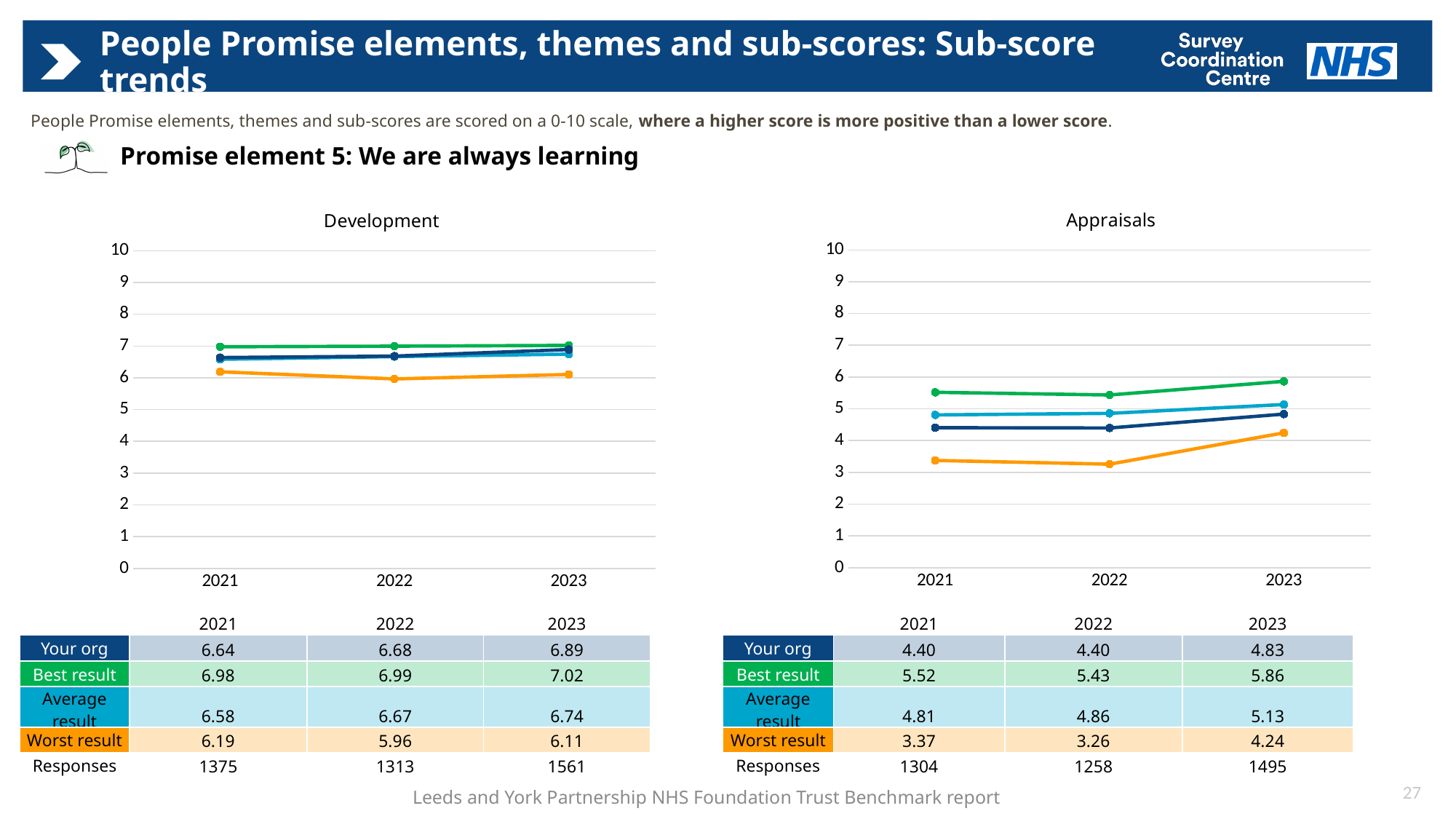
In the Development chart, what is the difference between the Best result and Your org values in 2021? 0.34 In the Appraisals chart, what is the Worst result value in 2022? 3.26 In the Appraisals chart, which is larger in 2021: Your org or Average result? Average result In the Appraisals chart, is the Worst result value for 2023 greater or less than 4? greater In the Appraisals chart, what is the difference between the Your org values in 2023 and 2022? 0.43 What kind of chart is the Appraisals chart? line chart In the Development chart, what is the value for Your org in 2023? 6.89 In the Appraisals chart, what is the Average result value in 2023? 5.13 How many years are plotted on the x axis of the Development chart? 3 In the Development chart, does the Your org line rise or fall from 2021 to 2023? rise In the Development chart, which year has the highest Best result value? 2023 In the Appraisals chart, which year has the lowest Worst result value? 2022